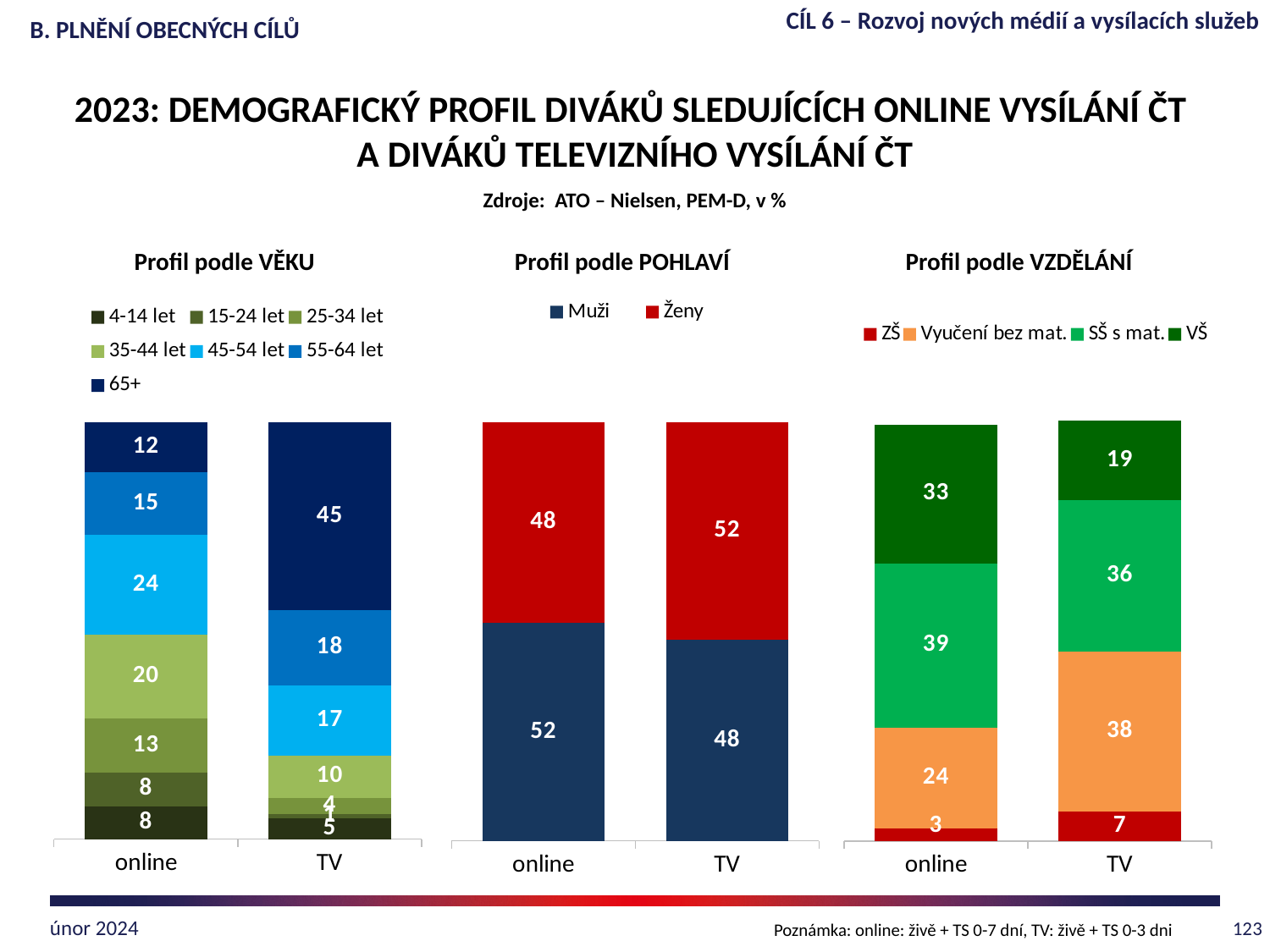
In the 'Profil podle VĚKU' chart, what is the value for 45-54 let in the online bar? 24 In the 'Profil podle VZDĚLÁNÍ' chart, which education segment is the largest in the TV bar? Vyučení bez mat. In the 'Profil podle VZDĚLÁNÍ' chart, what is the difference between the VŠ values for online and TV? 14 How many series does the legend of the 'Profil podle VĚKU' chart list? 7 In the 'Profil podle VĚKU' chart, what is the value for 65+ in the TV bar? 45 In the 'Profil podle POHLAVÍ' chart, what is the value for Muži in the online bar? 52 In the 'Profil podle VZDĚLÁNÍ' chart, what is the total of the online stacked bar? 99 In the 'Profil podle VZDĚLÁNÍ' chart, which education segment is the smallest in the online bar? ZŠ What kind of chart is the 'Profil podle POHLAVÍ' chart? Stacked bar chart In the 'Profil podle VĚKU' chart, which is larger: the 35-44 let value for online or for TV? online In the 'Profil podle VZDĚLÁNÍ' chart, what is the value for VŠ in the online bar? 33 In the 'Profil podle POHLAVÍ' chart, what is the value for Ženy in the TV bar? 52